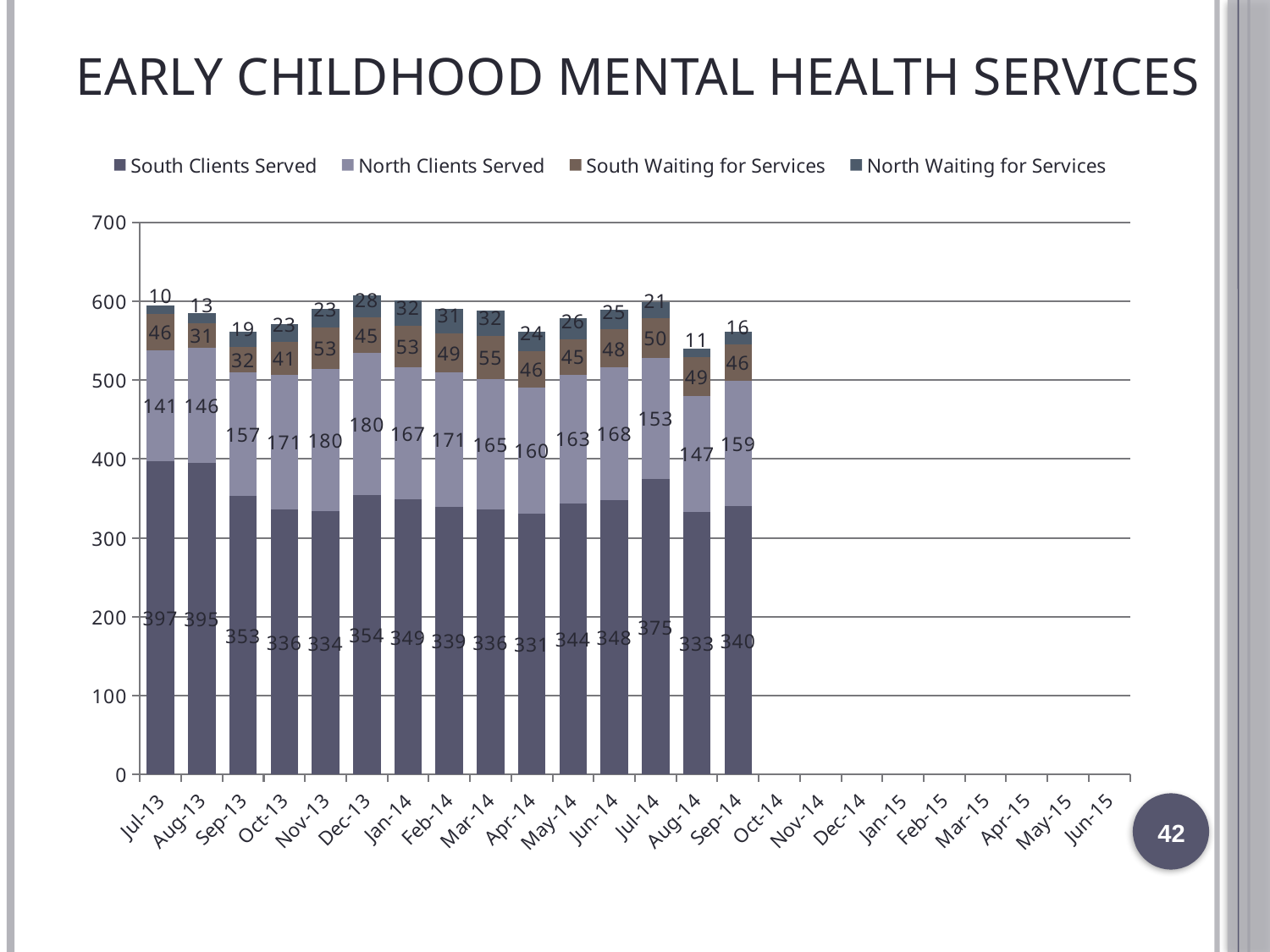
What is the total of the stacked bar for Dec-13? 607 Which is larger, North Clients Served in Sep-13 or in Sep-14? Sep-14 Which month has the lowest value for North Waiting for Services? Jul-13 What is the value of North Waiting for Services for Aug-14? 11 What type of chart is shown on the slide? Stacked bar chart What is the value of South Waiting for Services for Mar-14? 55 How many series does the legend list? 4 How many months have data plotted in the chart? 15 What is the value of South Clients Served for Jul-13? 397 What is the difference between South Clients Served in Jul-14 and Aug-14? 42 What is the value of North Clients Served for Nov-13? 180 Which month has the highest value for South Clients Served? Jul-13